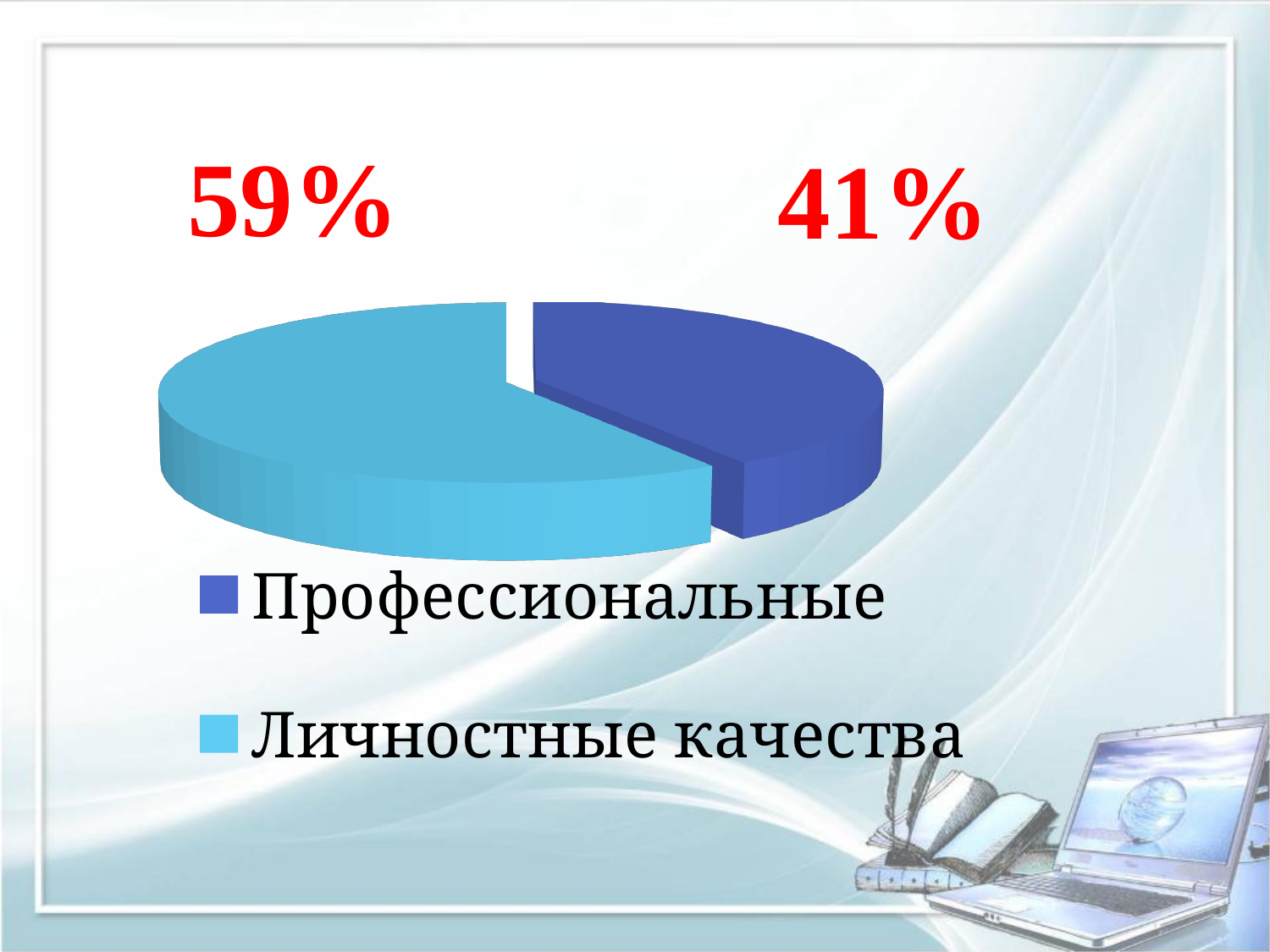
What share of the pie is labelled for Профессиональные? 41% Which is larger, the slice for Профессиональные or the slice for Личностные качества? Личностные качества What kind of chart is shown on the slide? pie chart How many slices does the pie chart have? 2 What share of the pie is labelled for Личностные качества? 59% Which slice is the smallest in the pie chart? Профессиональные What colour is the slice for Личностные качества? light blue Which slice is the largest in the pie chart? Личностные качества What is the difference in percentage points between the Личностные качества slice and the Профессиональные slice? 18 What colour is the slice for Профессиональные? dark blue How many entries does the legend list? 2 Is the share for Профессиональные greater or less than 50%? less